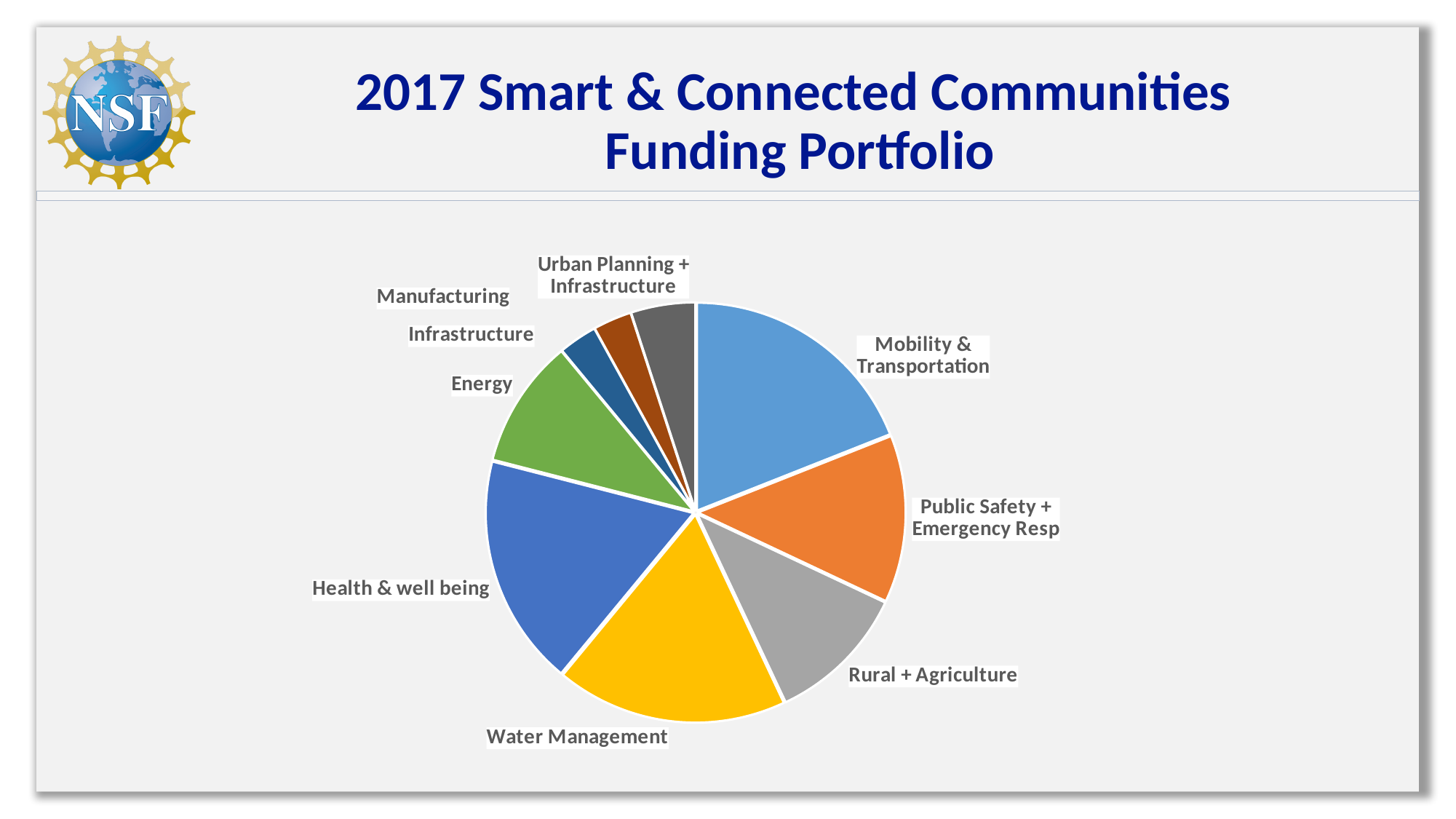
What colour is the Water Management slice? yellow Which slice is larger, Energy or Public Safety + Emergency Resp? Public Safety + Emergency Resp Which slice is larger, Health & well being or Manufacturing? Health & well being Which slice is larger, Infrastructure or Water Management? Water Management What kind of chart is shown on the slide? pie chart How many categories (slices) does the pie chart have? 9 What is the title of the slide containing the pie chart? 2017 Smart & Connected Communities Funding Portfolio